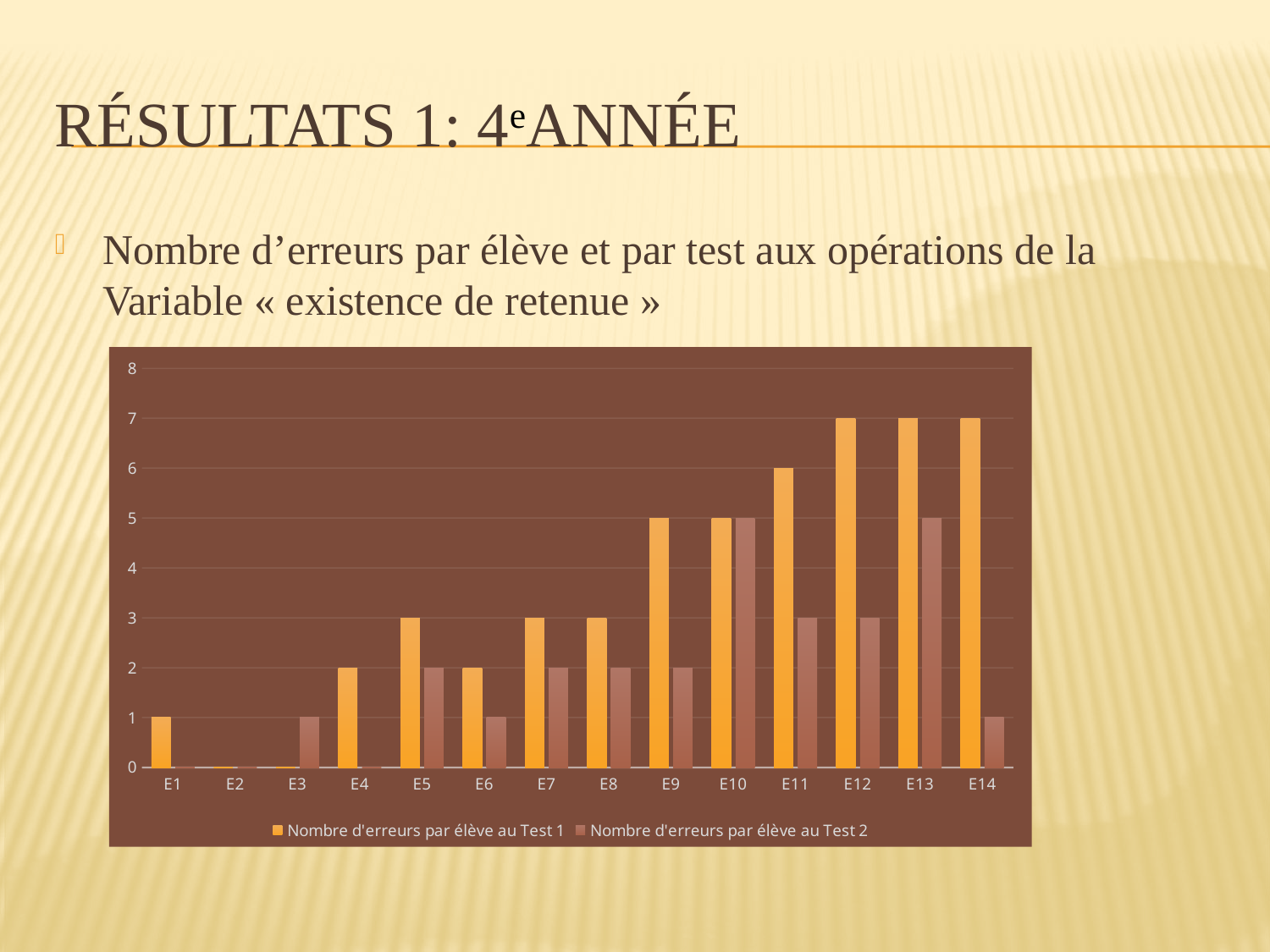
What kind of chart is shown on the slide? bar chart Is the value for E14 in the Test 1 series greater or less than 6? greater What is the difference between the Test 1 and Test 2 values for E11? 3 What is the value for E12 in the series 'Nombre d'erreurs par élève au Test 1'? 7 What is the value for E10 in the series 'Nombre d'erreurs par élève au Test 2'? 5 How many series does the chart legend list? 2 For E11, which series has the larger value, Test 1 or Test 2? Test 1 What is the name of the second series listed in the chart legend? Nombre d'erreurs par élève au Test 2 What is the value for E5 in the series 'Nombre d'erreurs par élève au Test 2'? 2 How many students (categories) are shown on the x axis of the chart? 14 Do the values of the series 'Nombre d'erreurs par élève au Test 1' generally rise or fall from E1 to E14? rise What is the value for E11 in the series 'Nombre d'erreurs par élève au Test 1'? 6